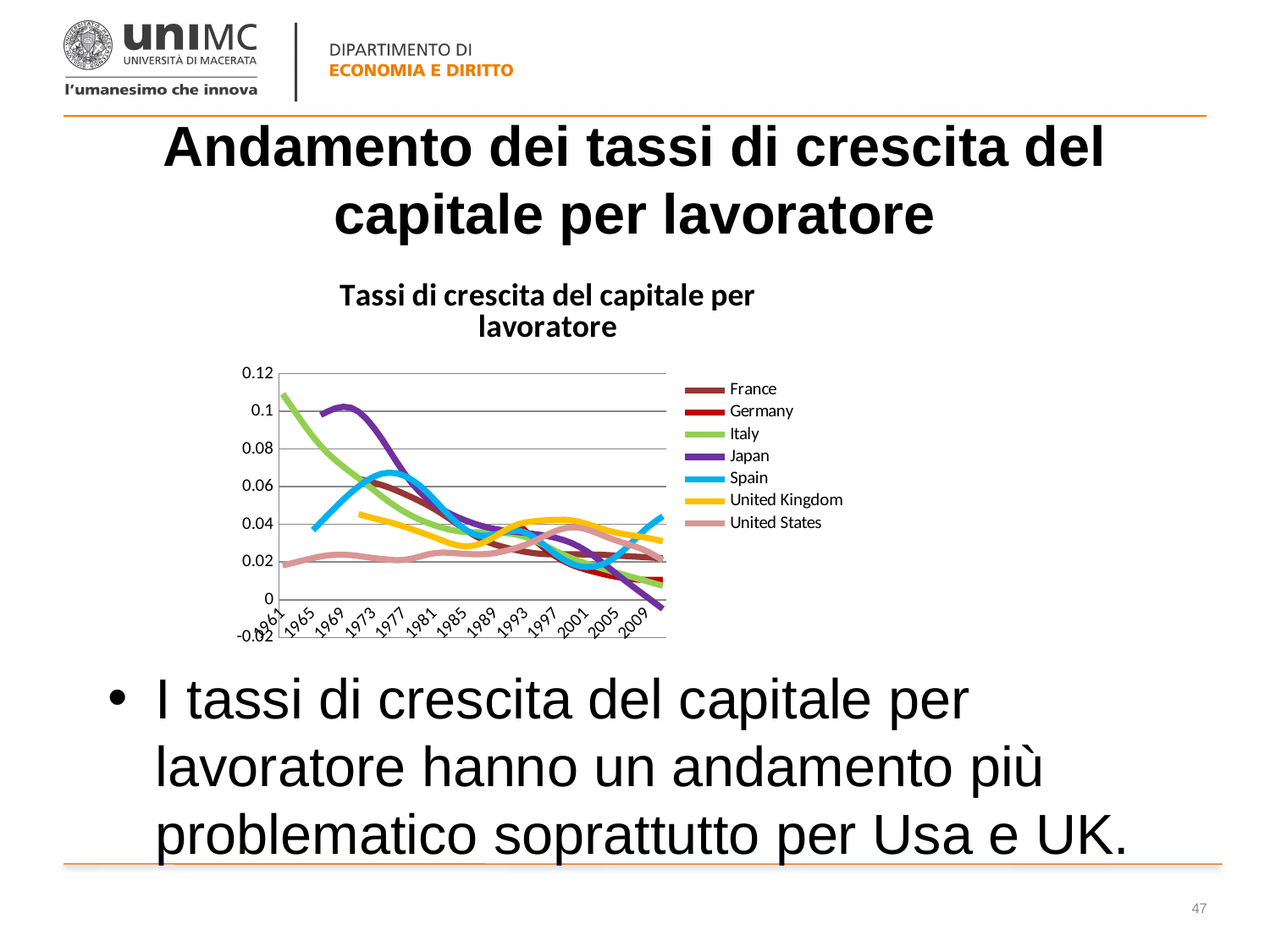
What is the title of the chart? Tassi di crescita del capitale per lavoratore What kind of chart is shown on the slide? line chart Is the value for Germany in 2009 greater or less than 0.02? less In 1961, which is larger: the value for Italy or the value for United States? Italy How many year labels are shown on the x axis of the chart? 13 Is the value for Italy in 1961 greater or less than 0.1? greater Does the Italy series rise or fall overall from 1961 to 2009? fall Which series has the lowest value in 2009? Japan Which countries are listed in the chart legend? France, Germany, Italy, Japan, Spain, United Kingdom, United States How many series does the legend of the chart list? 7